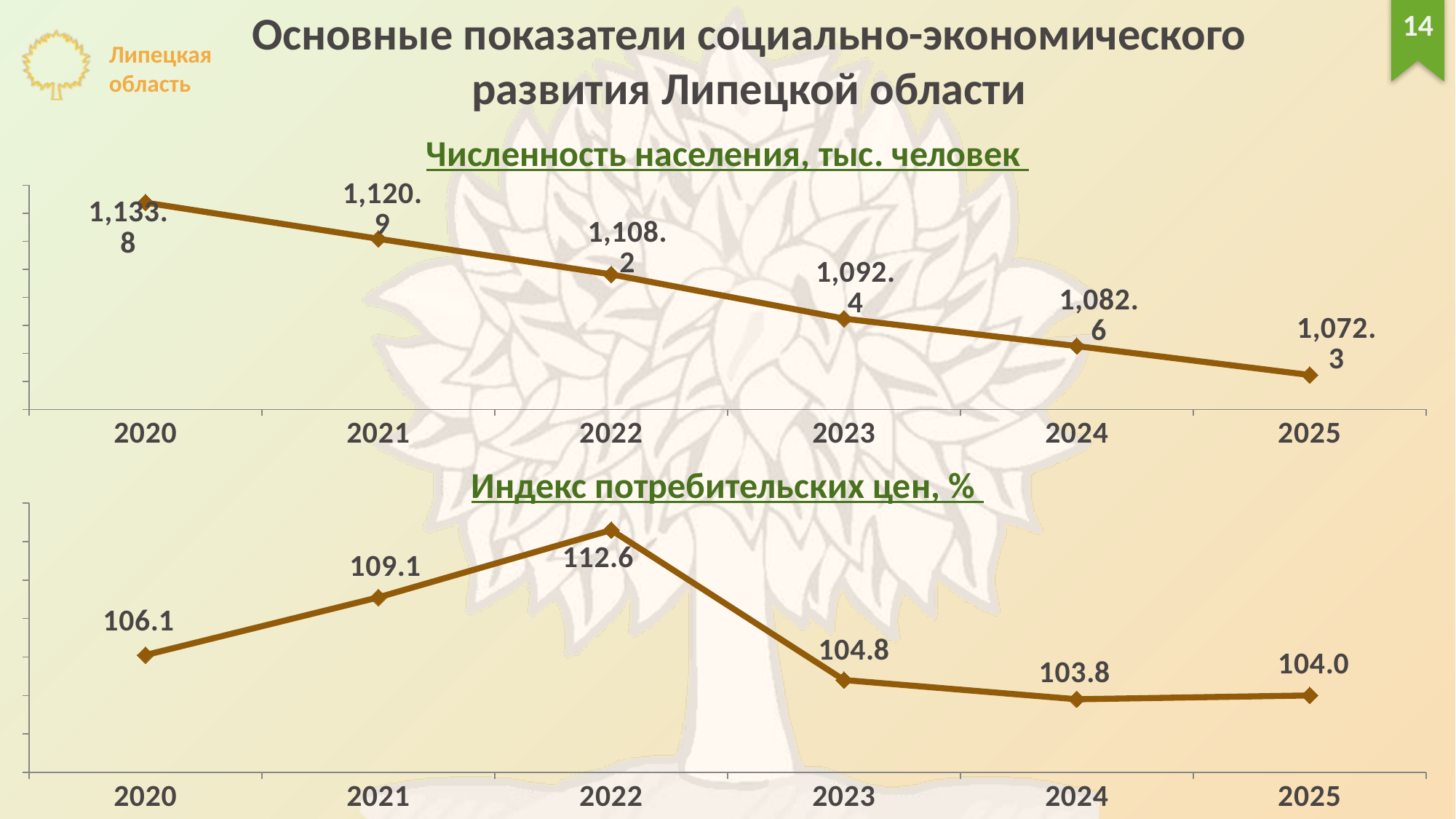
In the chart titled "Индекс потребительских цен, %", which year has the lowest value? 2024 In the chart titled "Численность населения, тыс. человек", what is the difference between the 2020 and 2025 values? 61.5 In the chart titled "Численность населения, тыс. человек", what is the value for 2025? 1,072.3 In the chart titled "Численность населения, тыс. человек", do the values rise or fall from 2020 to 2025? fall In the chart titled "Численность населения, тыс. человек", which year has the lowest value? 2025 What type of chart is the bottom chart titled "Индекс потребительских цен, %"? line chart In the chart titled "Индекс потребительских цен, %", which year has the highest value? 2022 In the chart titled "Индекс потребительских цен, %", what is the difference between the 2022 and 2023 values? 7.8 In the chart titled "Численность населения, тыс. человек", how many data points are plotted? 6 In the chart titled "Индекс потребительских цен, %", what is the value for 2022? 112.6 In the chart titled "Численность населения, тыс. человек", what is the value for 2020? 1,133.8 In the chart titled "Индекс потребительских цен, %", which is larger, the value for 2021 or the value for 2023? 2021